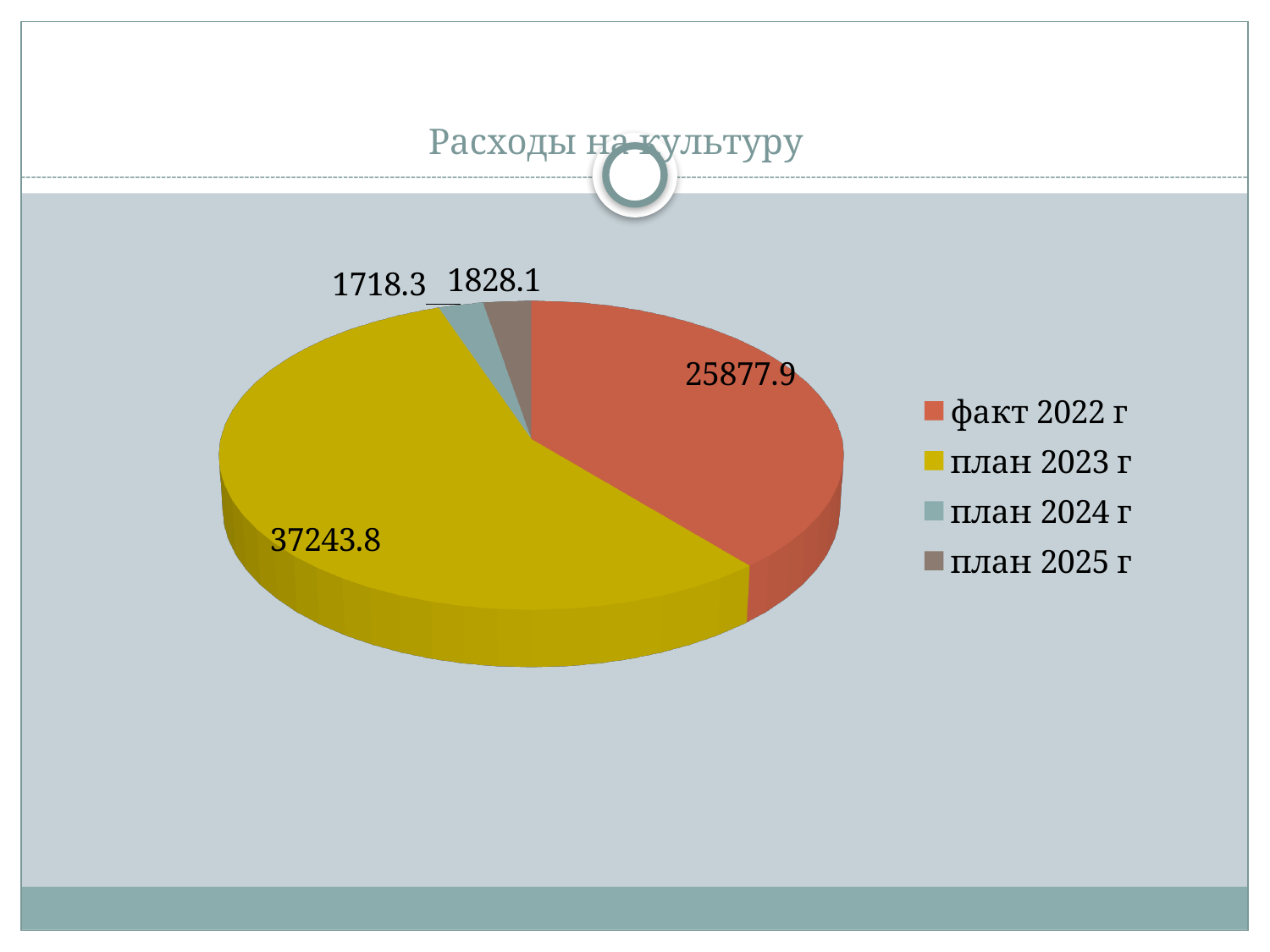
What is the value for план 2023 г in the pie chart? 37243.8 What is the title of the chart? Расходы на культуру What is the difference between the values for план 2023 г and факт 2022 г? 11365.9 Which category has the smallest slice in the pie chart? план 2024 г What is the value for план 2024 г in the pie chart? 1718.3 What type of chart is shown on the slide? pie chart What is the value for факт 2022 г in the pie chart? 25877.9 Which category has the largest slice in the pie chart? план 2023 г How many slices does the pie chart have? 4 What is the value for план 2025 г in the pie chart? 1828.1 Which is larger, the value for план 2025 г or the value for план 2024 г? план 2025 г What colour is the slice for план 2023 г? yellow